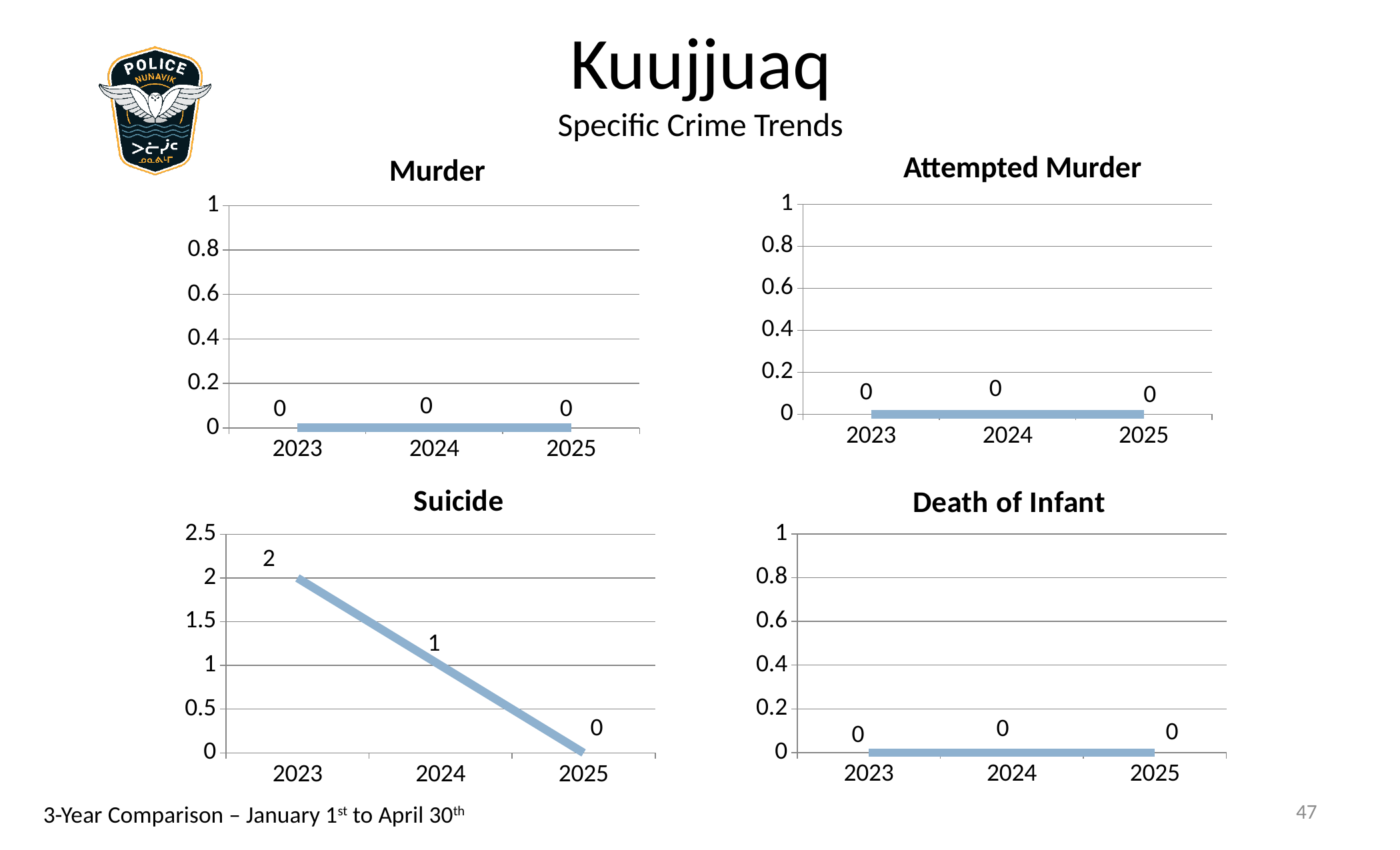
In the Death of Infant chart, what is the value for 2023? 0 In the Attempted Murder chart, what is the value for 2025? 0 In the Suicide chart, which year has the highest value? 2023 How many years are shown on the x axis of the Suicide chart? 3 What kind of chart is the Suicide chart? line chart In the Murder chart, what is the value for 2024? 0 In the Suicide chart, which year has the lowest value? 2025 In the Suicide chart, do the values rise or fall from 2023 to 2025? fall In the Suicide chart, what is the value for 2023? 2 In the Suicide chart, what is the value for 2024? 1 In the Suicide chart, what is the value for 2025? 0 In the Suicide chart, what is the difference between the 2023 and 2025 values? 2